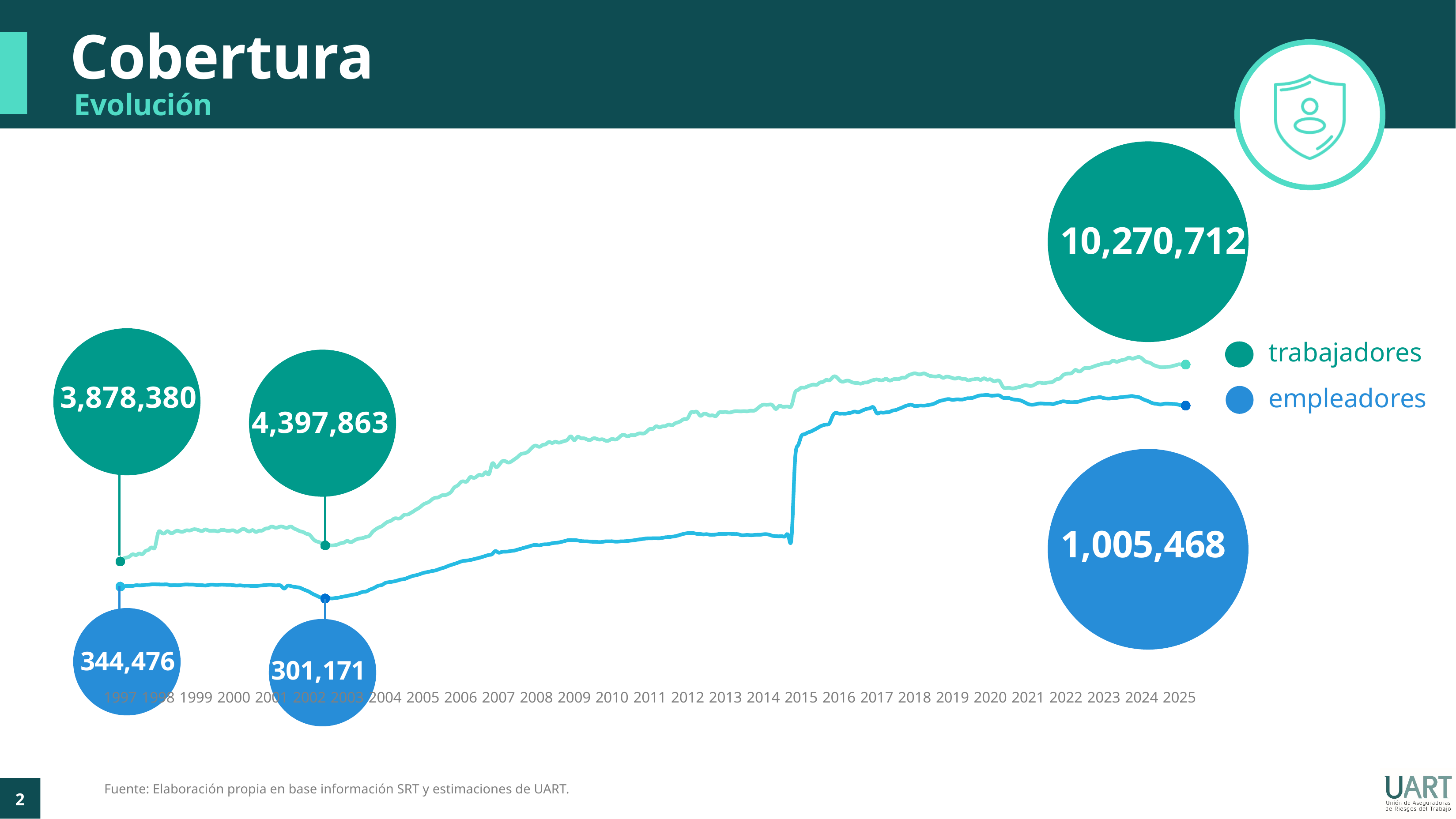
What value is shown in the second trabajadores callout from the left (at the dip around 2002–2003)? 4,397,863 How many series does the legend list? 2 Overall, does the trabajadores line rise or fall from 1997 to 2025? rise What are the two series named in the legend? trabajadores and empleadores By how much did the empleadores value increase from 1997 to 2025? 660,992 By how much did the trabajadores value increase from 1997 to 2025? 6,392,332 What value is shown in the second empleadores callout from the left (at the dip around 2002–2003)? 301,171 What is the value of trabajadores shown for 1997? 3,878,380 What is the value of trabajadores shown for 2025? 10,270,712 What kind of chart is shown on the slide? line chart What is the value of empleadores shown for 2025? 1,005,468 What is the value of empleadores shown for 1997? 344,476